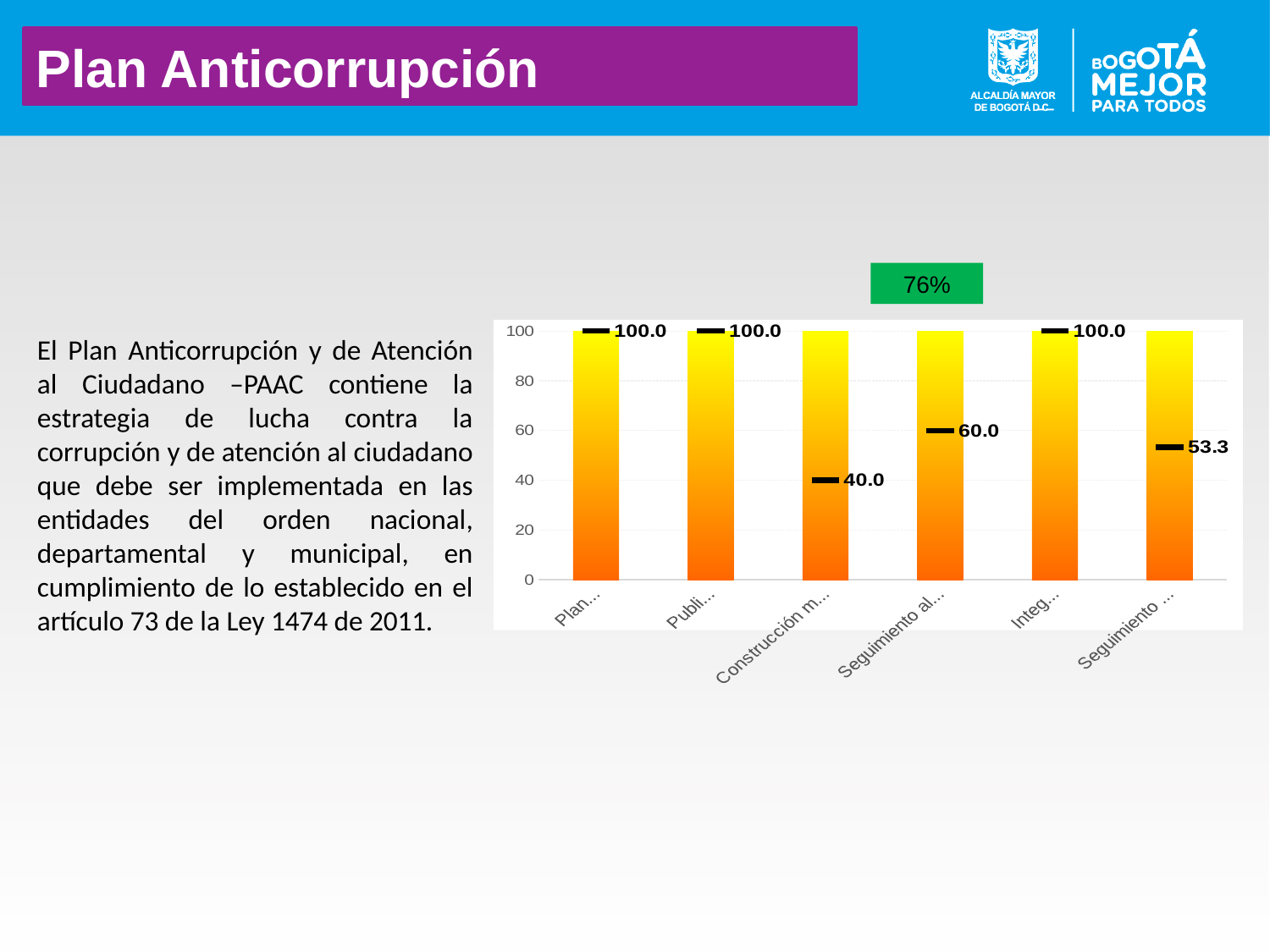
Is the labelled value for the rightmost bar greater or less than 60? less What kind of chart is shown on the slide? bar chart How many categories have a labelled value of 100.0? 3 Which has the larger labelled value: the fourth bar ("Seguimiento al...") or the rightmost bar? the fourth bar (Seguimiento al...) What is the labelled value for the first category ("Plan...")? 100.0 Which category has the lowest labelled value in the chart? Construcción m... (third bar) What is the labelled value for the rightmost category in the chart? 53.3 What percentage is shown in the green box above the chart? 76% What is the labelled value for the fourth category from the left ("Seguimiento al...")? 60.0 What is the difference between the labelled values of the fourth bar (60.0) and the third bar (40.0)? 20.0 How many categories (bars) are plotted in the chart? 6 What is the labelled value for the third category from the left ("Construcción m...")? 40.0